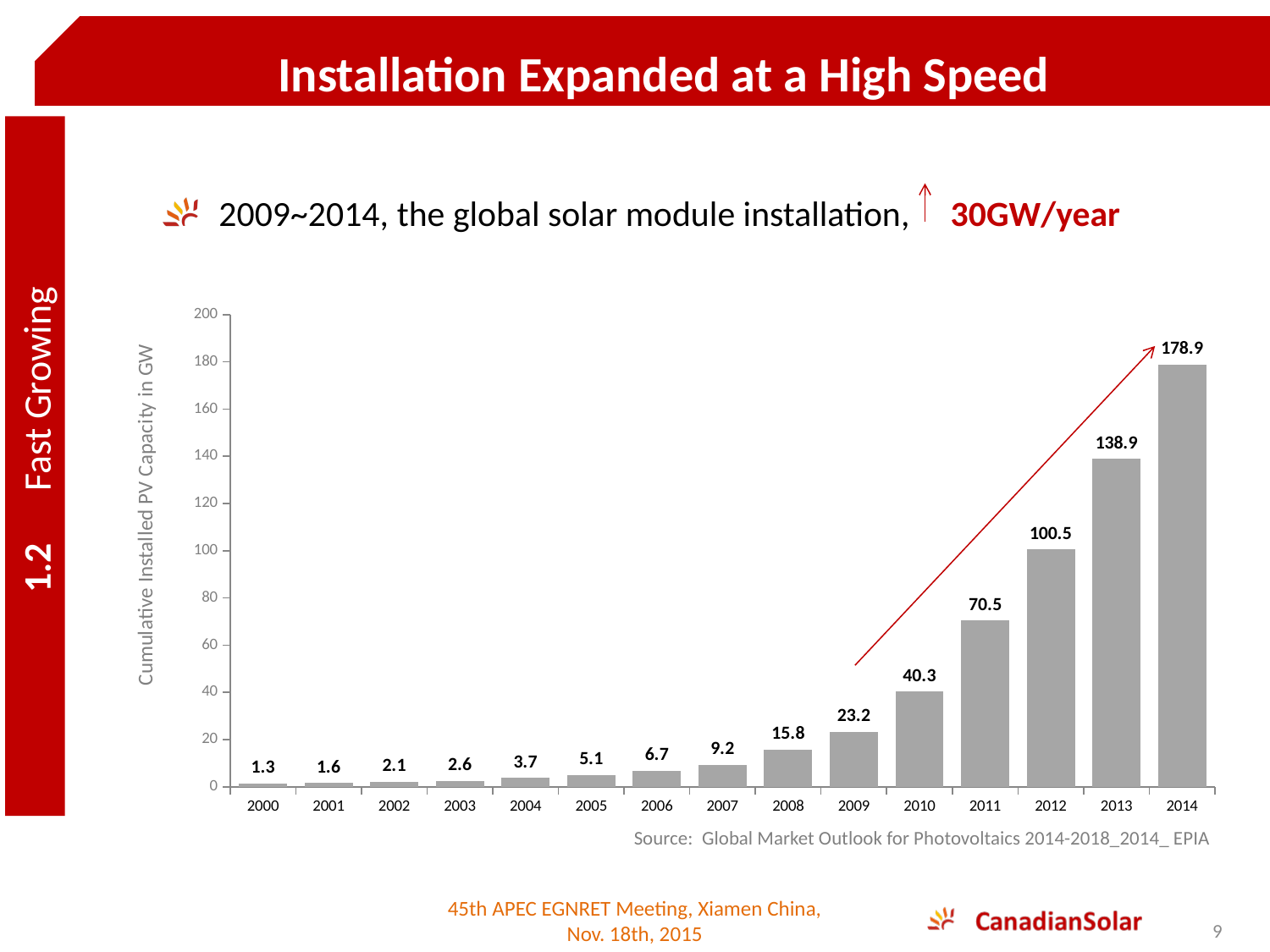
What type of chart is shown on the slide? bar chart How many years are shown on the x axis of the chart? 15 What is the difference in cumulative installed PV capacity between 2012 and 2011? 30.0 What is the cumulative installed PV capacity in 2004? 3.7 Which year has a larger cumulative installed PV capacity, 2010 or 2008? 2010 What is the difference in cumulative installed PV capacity between 2014 and 2013? 40.0 Which year has the lowest cumulative installed PV capacity? 2000 What is the cumulative installed PV capacity in 2014? 178.9 Which year has the highest cumulative installed PV capacity? 2014 What is the cumulative installed PV capacity in 2009? 23.2 Do the values rise or fall from 2000 to 2014? rise Is the value for 2011 greater or less than 60? greater